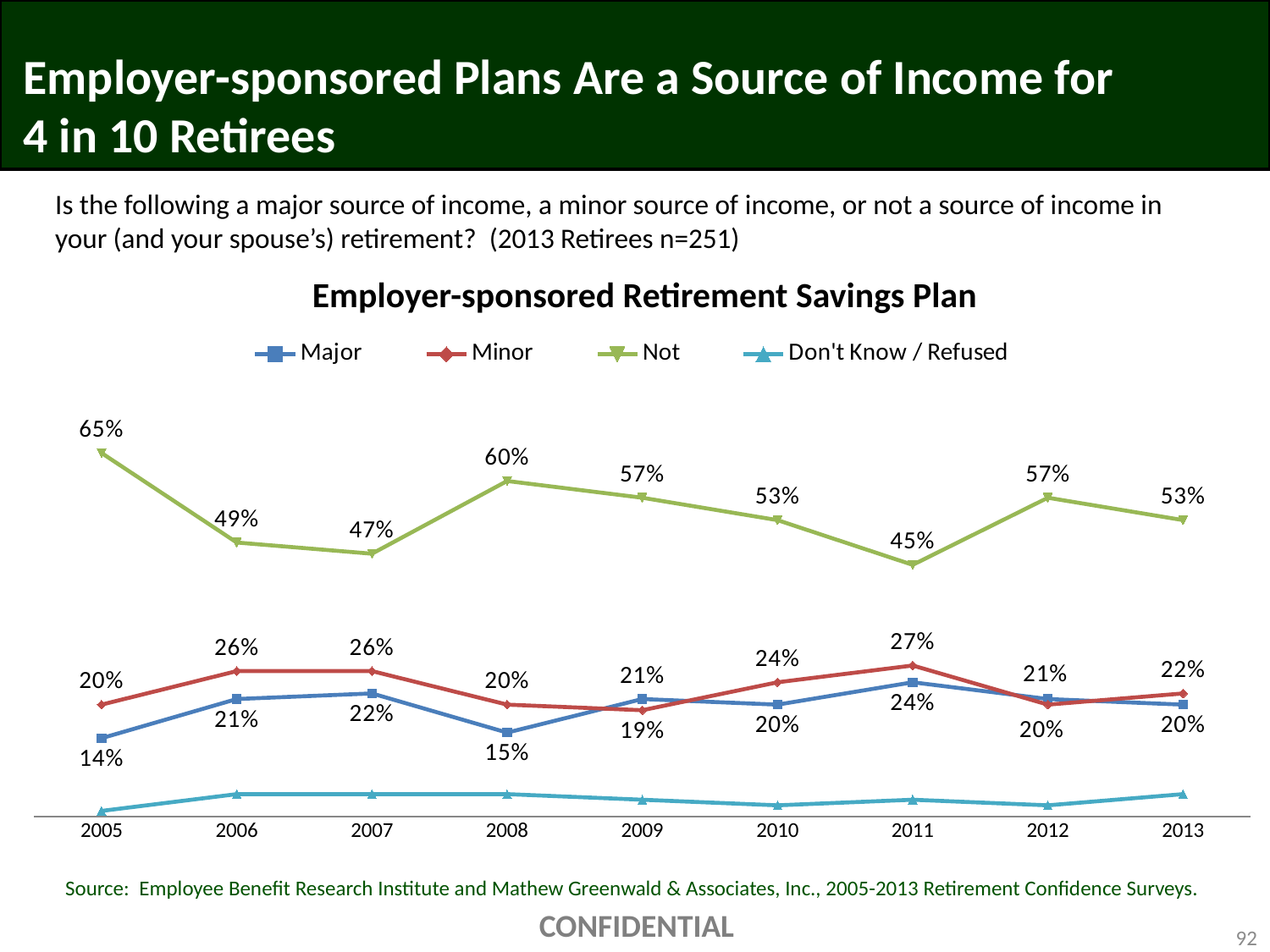
What is the value for the Major series in 2005? 14% What is the difference between the Not series value in 2005 and in 2013? 12 percentage points What kind of chart is shown on the slide? Line chart In 2008, which is larger, the Major series or the Minor series? Minor How many series does the legend list? 4 What is the value for the Not series in 2008? 60% What is the value for the Minor series in 2011? 27% In which year is the Not series at its highest? 2005 In which year is the Not series at its lowest? 2011 What is the value for the Not series in 2005? 65% How many years are plotted along the x axis? 9 Does the Not series rise or fall from 2005 to 2007? Fall